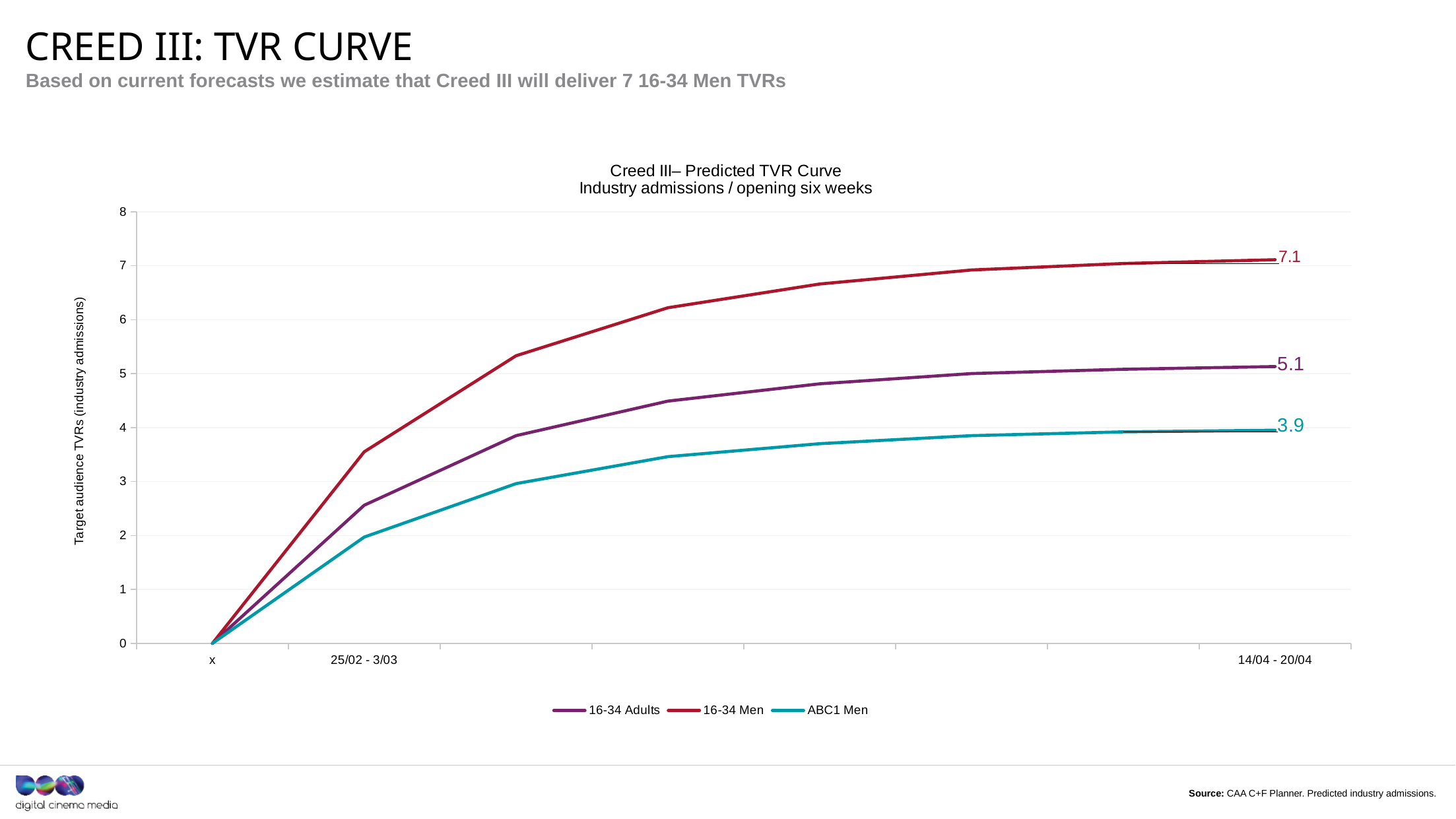
Which is larger at the end of the curve, 16-34 Adults or ABC1 Men? 16-34 Adults Do the values rise or fall along the x axis? Rise What is the difference between the final values of 16-34 Adults and ABC1 Men? 1.2 What is the final value of the 16-34 Men line at 14/04 - 20/04? 7.1 What is the difference between the final values of 16-34 Men and 16-34 Adults? 2.0 What is the final value of the 16-34 Adults line at 14/04 - 20/04? 5.1 What is the final value of the ABC1 Men line at 14/04 - 20/04? 3.9 Which series reaches the lowest value at the end of the curve? ABC1 Men Is the value for 16-34 Men at 25/02 - 3/03 greater or less than 4? less What kind of chart is shown on the slide? Line chart How many series does the legend list? 3 Which series reaches the highest value at the end of the curve? 16-34 Men